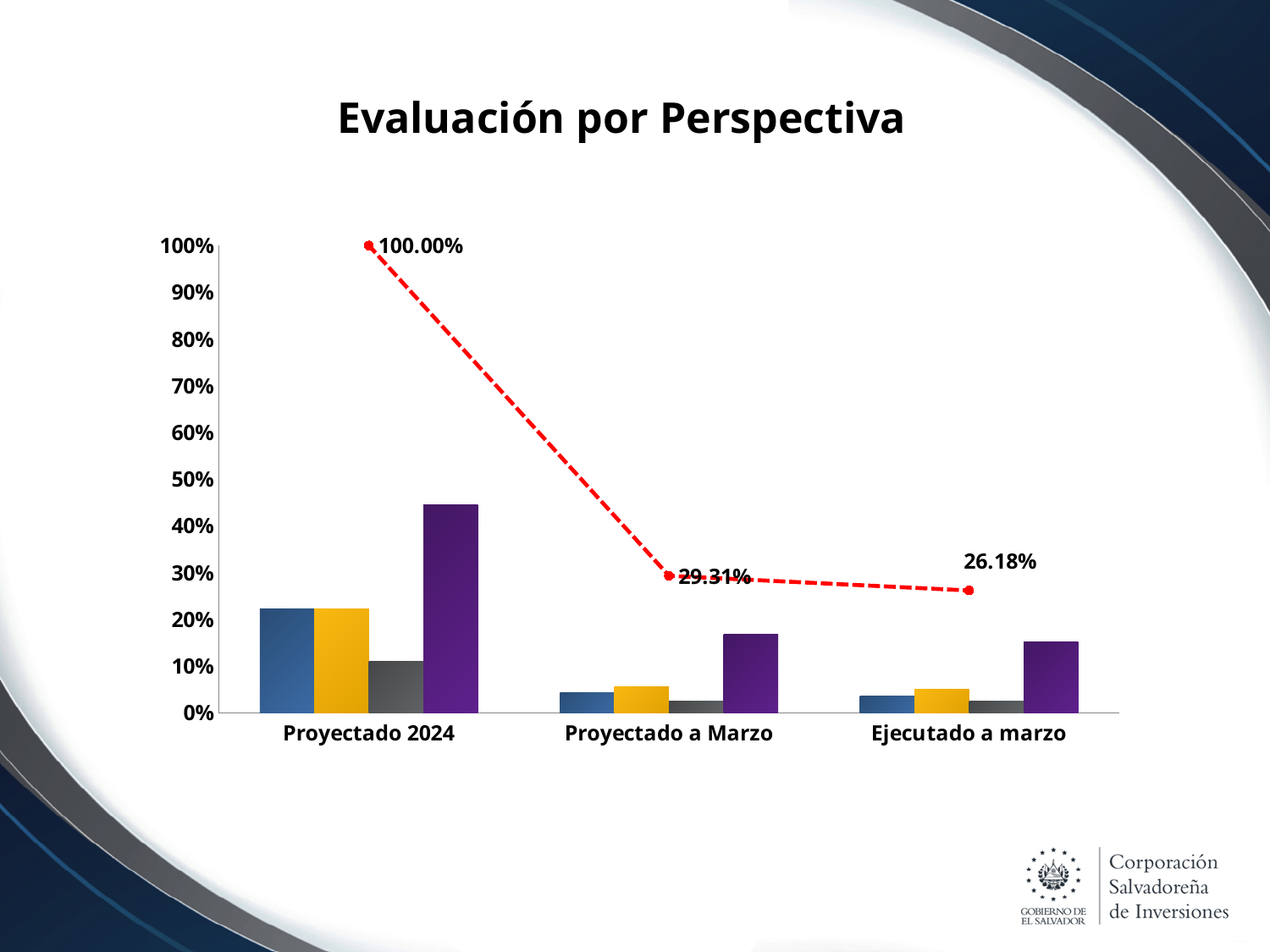
For which category is the red dashed line highest? Proyectado 2024 Which has the larger red dashed line value, Proyectado a Marzo or Ejecutado a marzo? Proyectado a Marzo What is the value of the red dashed line for Proyectado a Marzo? 29.31% What kind of chart is shown on the slide? Combined bar and line chart How many categories are shown on the x axis? 3 What is the difference between the red dashed line values for Proyectado a Marzo and Ejecutado a marzo? 3.13% For which category is the red dashed line lowest? Ejecutado a marzo Does the red dashed line rise or fall from left to right across the categories? Fall What is the value of the red dashed line for Proyectado 2024? 100.00% What is the difference between the red dashed line values for Proyectado 2024 and Proyectado a Marzo? 70.69% What is the value of the red dashed line for Ejecutado a marzo? 26.18% What is the title of the chart? Evaluación por Perspectiva